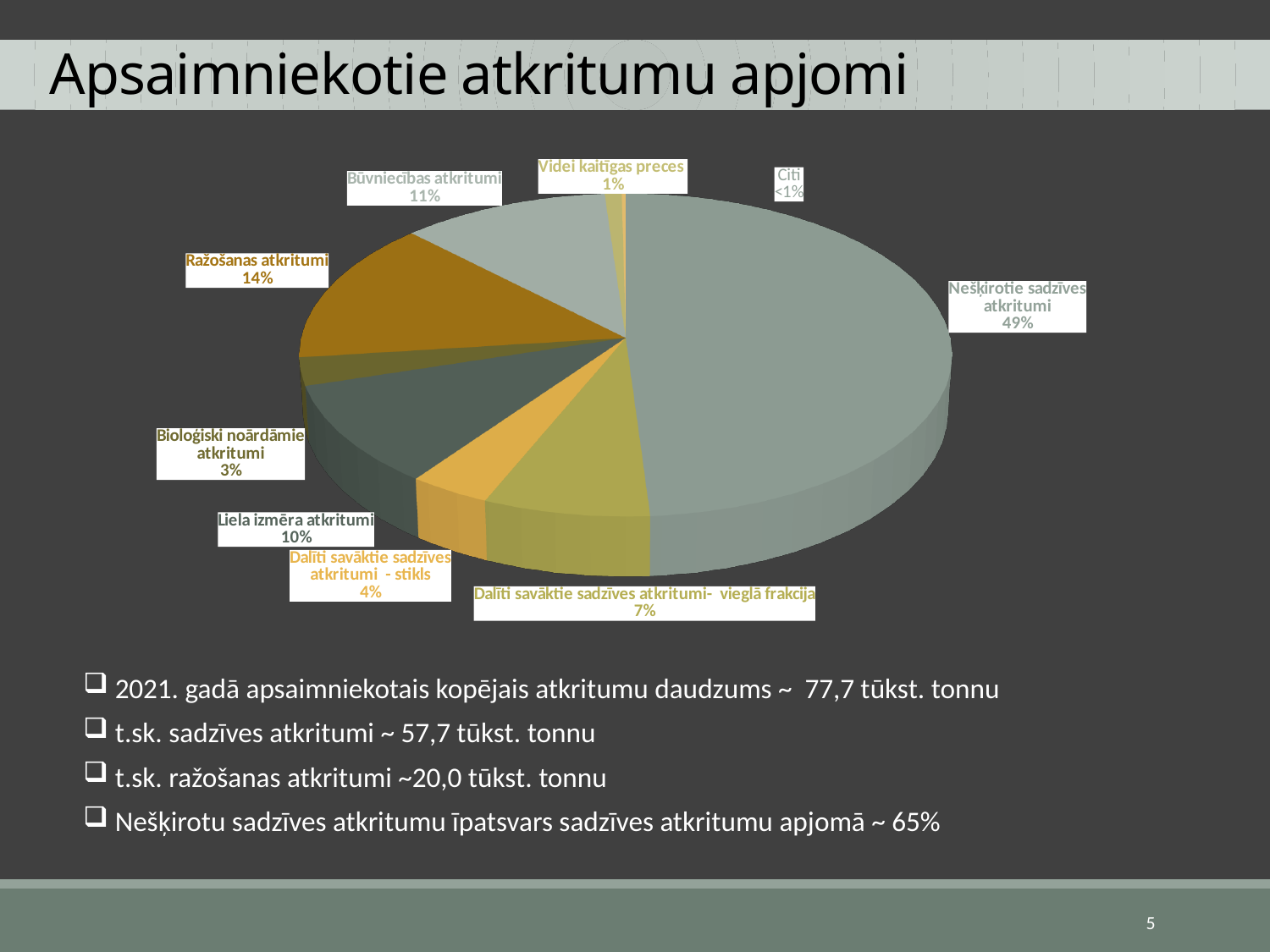
What percentage is shown for Būvniecības atkritumi? 11% How many categories are shown in the pie chart? 9 What percentage is shown for Ražošanas atkritumi? 14% Which category has the largest slice of the pie? Nešķirotie sadzīves atkritumi What is the difference in percentage points between Liela izmēra atkritumi and Bioloģiski noārdāmie atkritumi? 7 What value is shown for the Citi slice? <1% Which category has the smallest slice of the pie? Citi What percentage is shown for Dalīti savāktie sadzīves atkritumi - stikls? 4% What share of the pie is labelled for Nešķirotie sadzīves atkritumi? 49% Which is larger, the share for Ražošanas atkritumi or the share for Būvniecības atkritumi? Ražošanas atkritumi What percentage is shown for Liela izmēra atkritumi? 10% What type of chart is shown on the slide? pie chart